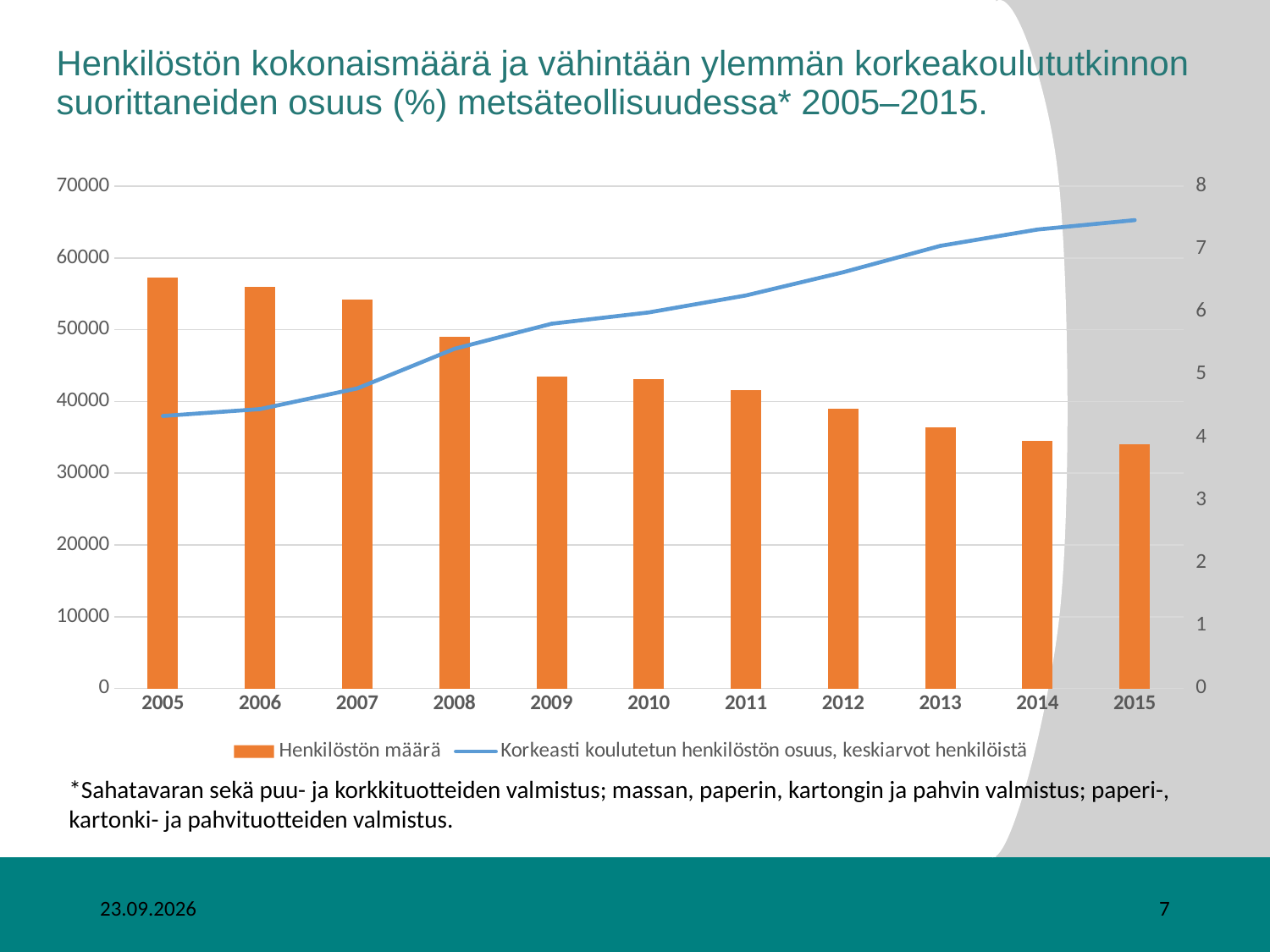
Which is larger, Henkilöstön määrä in 2007 or in 2012? 2007 Is the value for Henkilöstön määrä in 2005 greater or less than 50000? greater What kind of chart is shown on the slide? A combined bar and line chart Which year has the highest value for Henkilöstön määrä? 2005 Do the values for Henkilöstön määrä rise or fall from 2005 to 2015? fall Which year has the highest value for Korkeasti koulutetun henkilöstön osuus? 2015 Which year has the lowest value for Korkeasti koulutetun henkilöstön osuus? 2005 Is the value for Henkilöstön määrä in 2015 greater or less than 40000? less Is the value for Korkeasti koulutetun henkilöstön osuus in 2015 greater or less than 7? greater How many series does the chart legend list? 2 Which series is drawn as a line in the chart? Korkeasti koulutetun henkilöstön osuus, keskiarvot henkilöistä How many years are shown on the x axis of the chart? 11